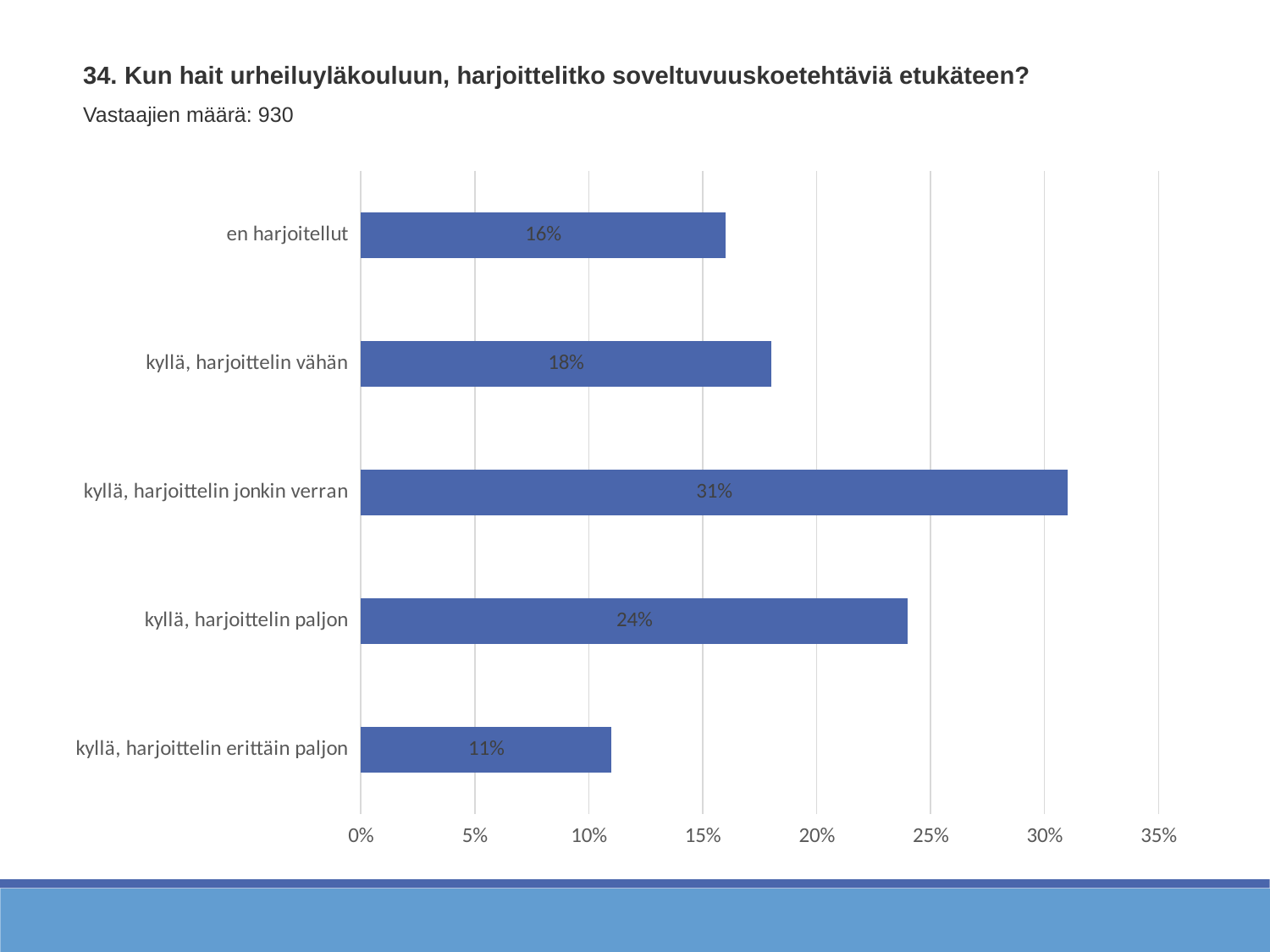
What is the value for "kyllä, harjoittelin paljon"? 24% What is the value for "kyllä, harjoittelin jonkin verran"? 31% What percentage of respondents answered "en harjoitellut"? 16% What is the difference between "kyllä, harjoittelin jonkin verran" and "kyllä, harjoittelin paljon"? 7% Which is larger: "en harjoitellut" or "kyllä, harjoittelin vähän"? kyllä, harjoittelin vähän How many categories are shown in the chart? 5 How many respondents (Vastaajien määrä) are reported on the slide? 930 Which category has the highest value? kyllä, harjoittelin jonkin verran Is the value for "kyllä, harjoittelin paljon" greater or less than 20%? greater What kind of chart is shown on the slide? bar chart Which category has the lowest value? kyllä, harjoittelin erittäin paljon What is the value for "kyllä, harjoittelin erittäin paljon"? 11%